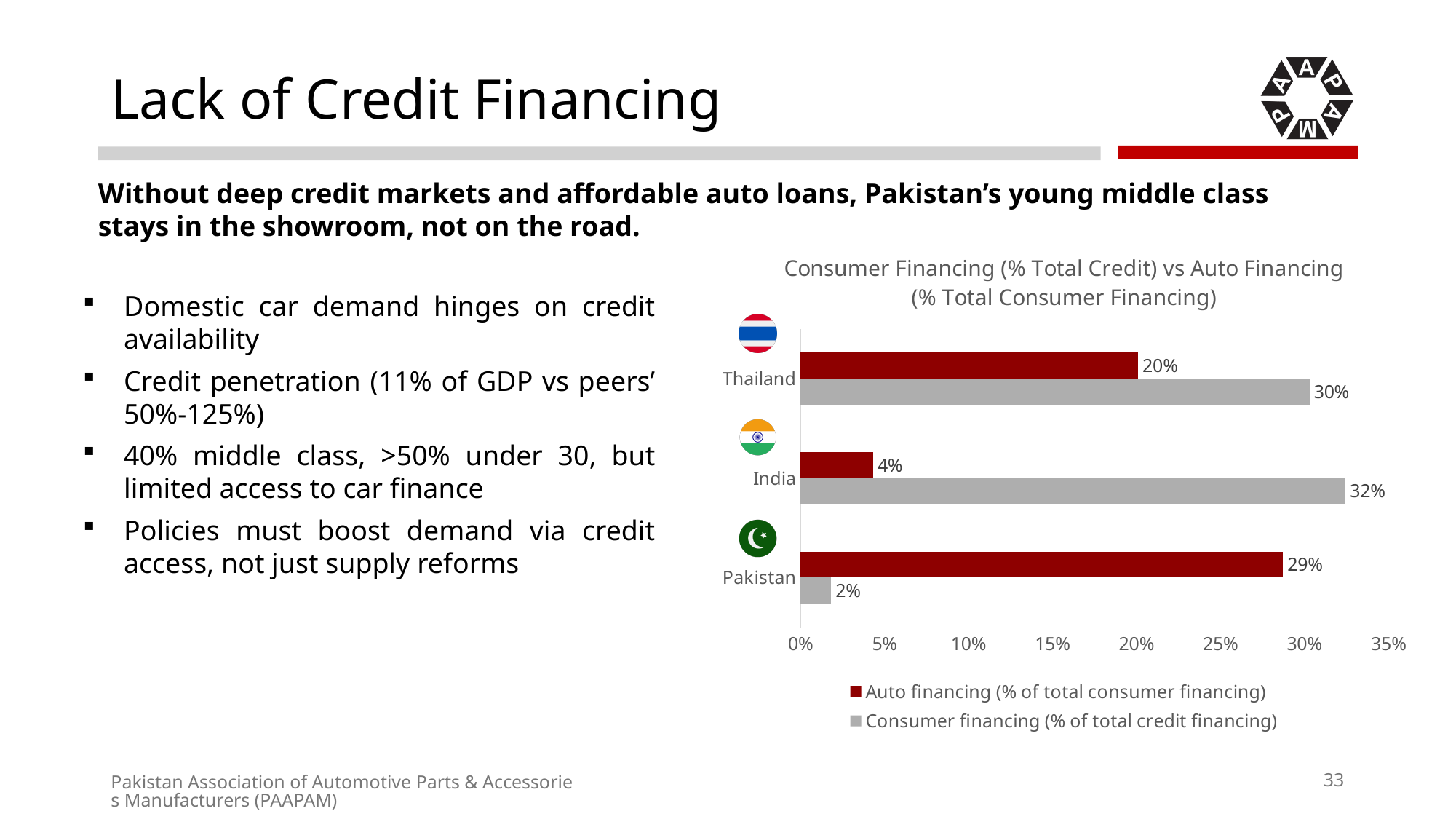
What is the Auto financing (% of total consumer financing) value for Pakistan? 29% How many series does the legend list? 2 What is the Auto financing (% of total consumer financing) value for Thailand? 20% What is the Consumer financing (% of total credit financing) value for Pakistan? 2% Which is larger for India: the Auto financing value or the Consumer financing value? Consumer financing Which country has the highest Auto financing (% of total consumer financing) value? Pakistan What type of chart is shown on the slide? Bar chart What is the Consumer financing (% of total credit financing) value for India? 32% How many countries are shown in the chart? 3 What is the difference between the Consumer financing and Auto financing values for Thailand? 10% Which country has the lowest Consumer financing (% of total credit financing) value? Pakistan Is the Consumer financing (% of total credit financing) value for India greater or less than 30%? greater